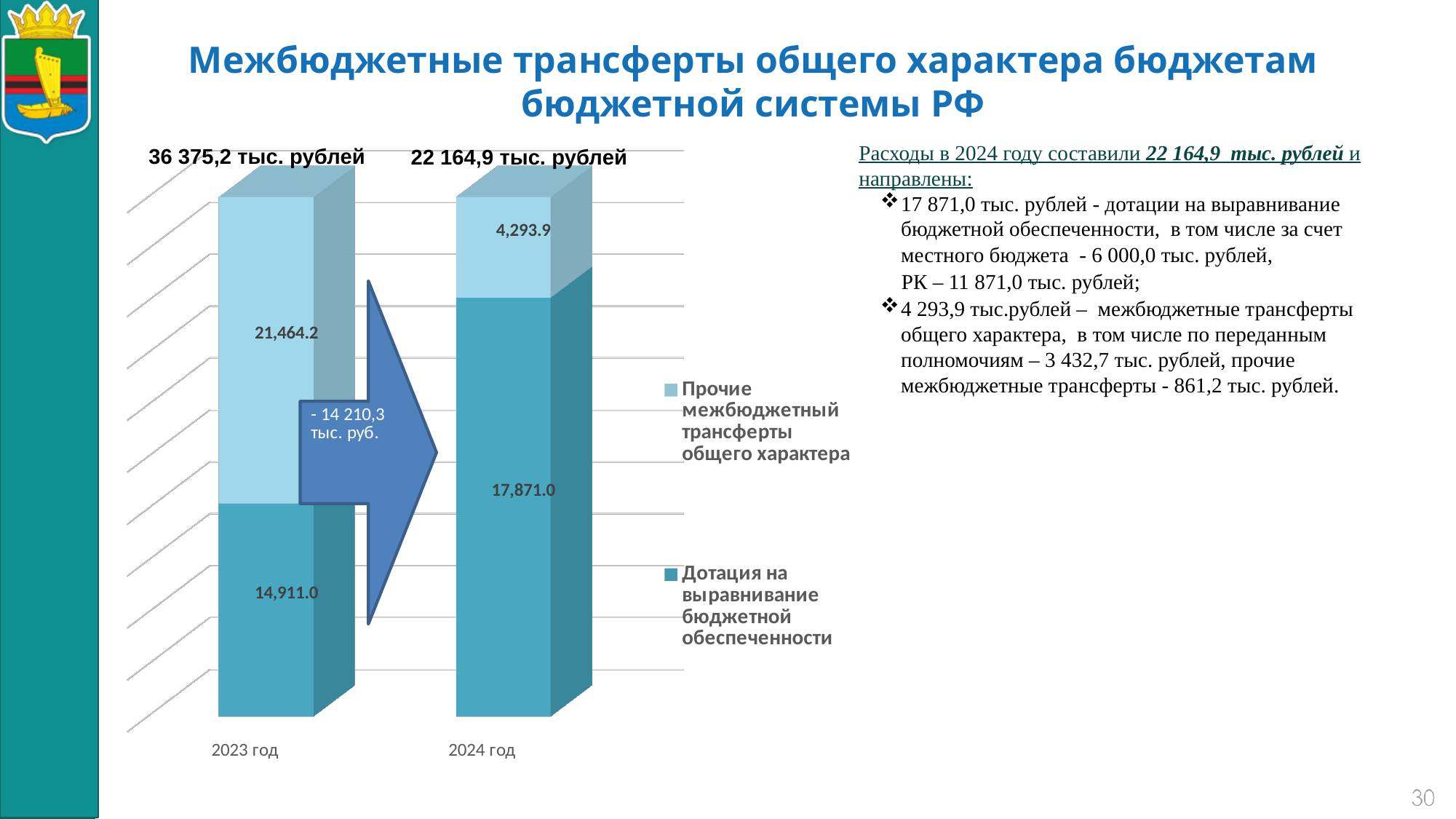
What is the value of 'Дотация на выравнивание бюджетной обеспеченности' for 2024 год? 17,871.0 What change is written on the arrow between the 2023 год and 2024 год bars? - 14 210,3 тыс. руб. Which year has the larger value for 'Дотация на выравнивание бюджетной обеспеченности', 2023 год or 2024 год? 2024 год What is the value of 'Дотация на выравнивание бюджетной обеспеченности' for 2023 год? 14,911.0 Which year has the larger value for 'Прочие межбюджетный трансферты общего характера', 2023 год or 2024 год? 2023 год What is the value of 'Прочие межбюджетный трансферты общего характера' for 2023 год? 21,464.2 What is the value of 'Прочие межбюджетный трансферты общего характера' for 2024 год? 4,293.9 What kind of chart is shown on the slide? Stacked bar chart What is the total shown above the 2024 год bar? 22 164,9 тыс. рублей What is the difference between the 'Дотация на выравнивание бюджетной обеспеченности' values for 2024 год and 2023 год? 2,960.0 What is the total shown above the 2023 год bar? 36 375,2 тыс. рублей How many series does the legend list? 2